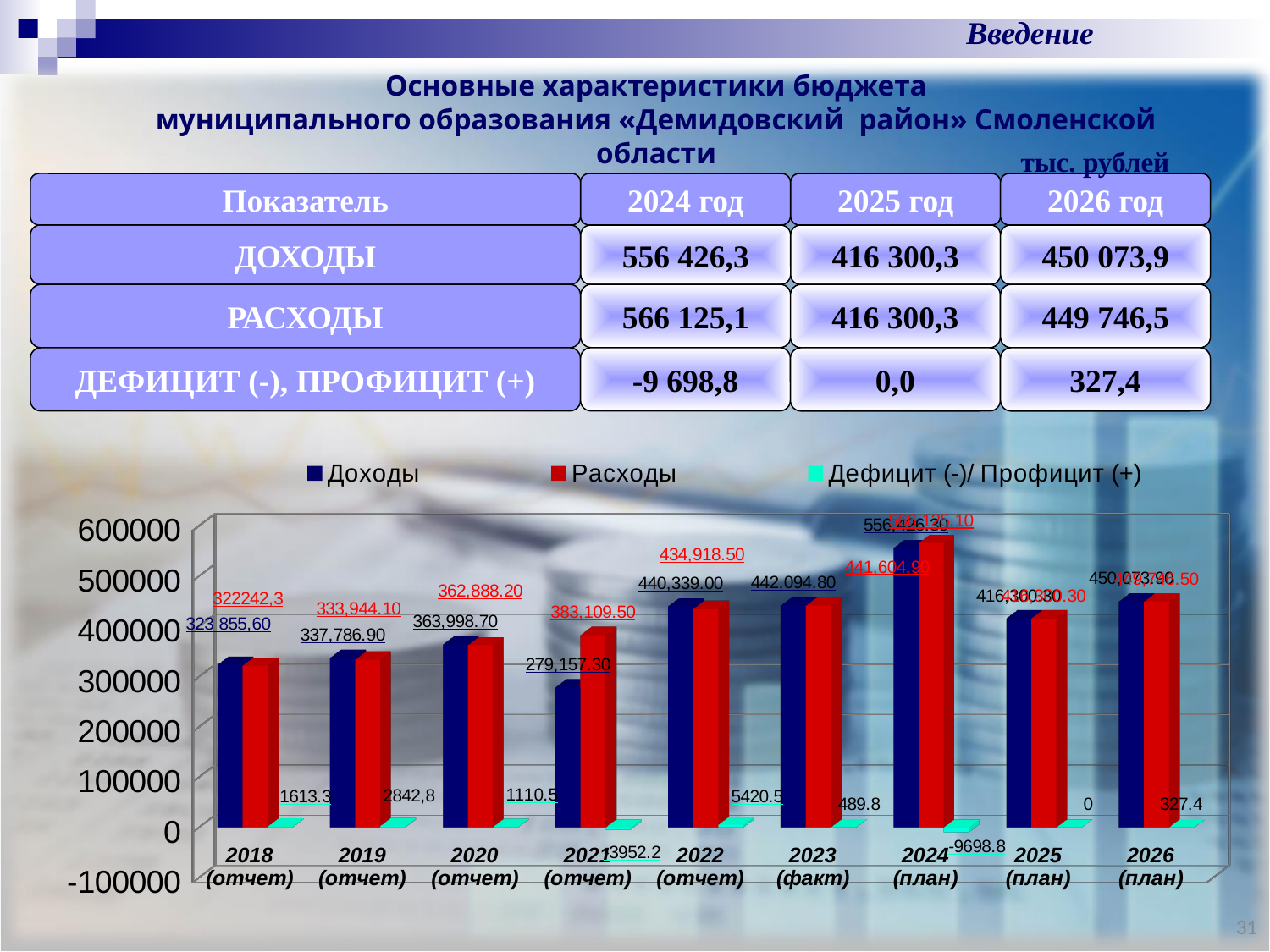
What is the value of Расходы for 2022 (отчет) in the chart? 434,918.50 What is the value of Доходы for 2019 (отчет) in the chart? 337,786.90 Which year has the highest Доходы value in the chart? 2024 (план) What is the difference between Доходы and Расходы for 2022 (отчет) in the chart? 5,420.50 How many year categories are shown on the x axis of the chart? 9 What is the value of Дефицит (-)/ Профицит (+) for 2024 (план) in the chart? -9698.8 What kind of chart is shown on the slide? bar chart Is the Доходы value for 2018 (отчет) greater or less than 400000? less Do the Расходы values rise or fall from 2018 (отчет) to 2020 (отчет)? rise How many series does the chart legend list? 3 Which year has the lowest Доходы value in the chart? 2021 (отчет) In 2021 (отчет), which is larger in the chart: Доходы or Расходы? Расходы